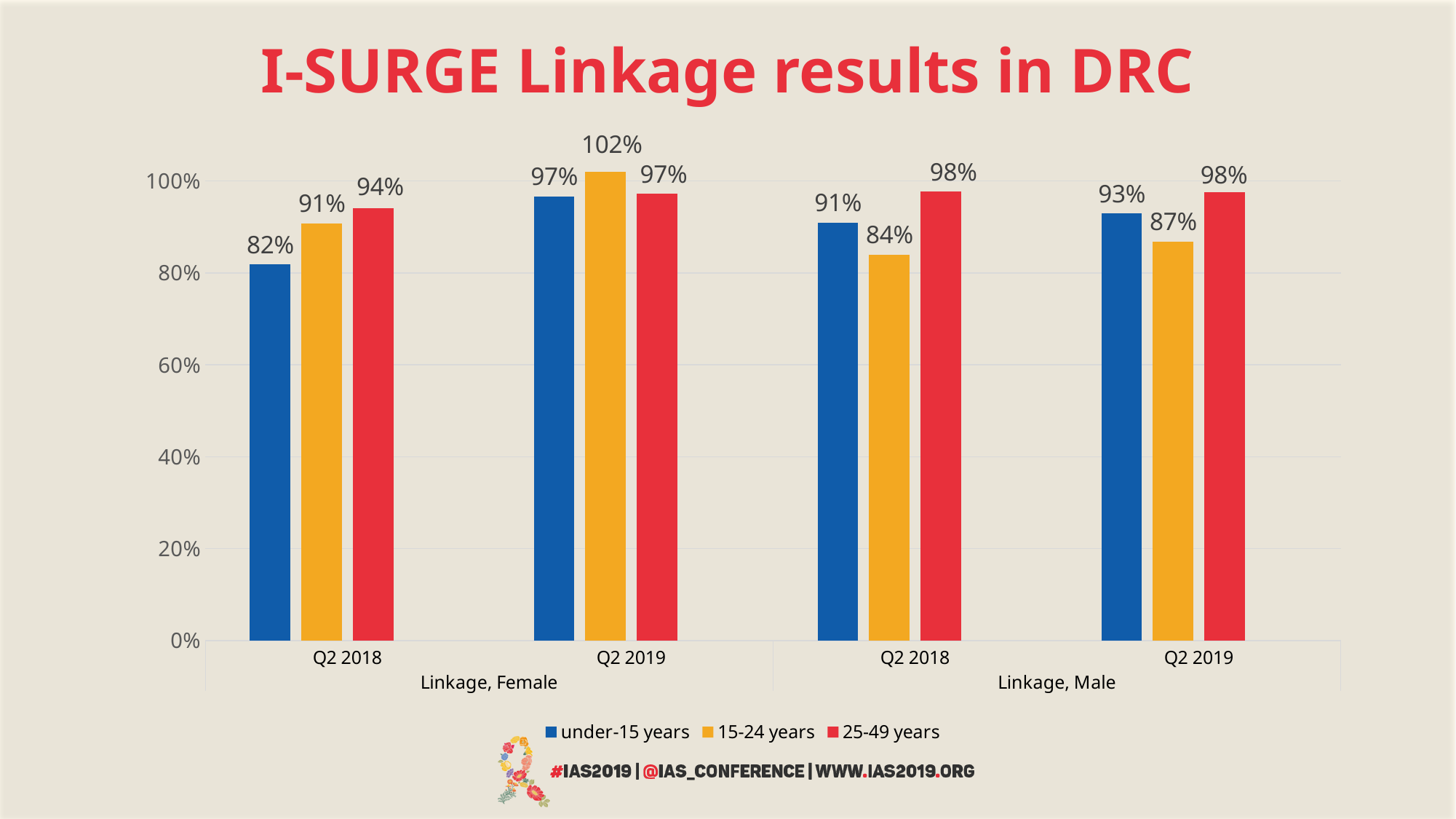
What is the difference between the under-15 years values for Linkage, Female in Q2 2019 and Q2 2018? 15% What is the value for 15-24 years in Q2 2019 for Linkage, Female? 102% What is the value for 25-49 years in Q2 2018 for Linkage, Male? 98% Does the under-15 years value for Linkage, Male rise or fall from Q2 2018 to Q2 2019? Rise Which age group has the highest value in Q2 2019 for Linkage, Female? 15-24 years How many series does the legend list? 3 What is the value for 15-24 years in Q2 2019 for Linkage, Male? 87% Which is larger: the 15-24 years value in Q2 2018 for Linkage, Female or the 15-24 years value in Q2 2018 for Linkage, Male? Linkage, Female (91%) What is the title of the chart? I-SURGE Linkage results in DRC What is the value for under-15 years in Q2 2018 for Linkage, Female? 82% Which age group has the lowest value in Q2 2018 for Linkage, Male? 15-24 years What kind of chart is shown on the slide? Bar chart